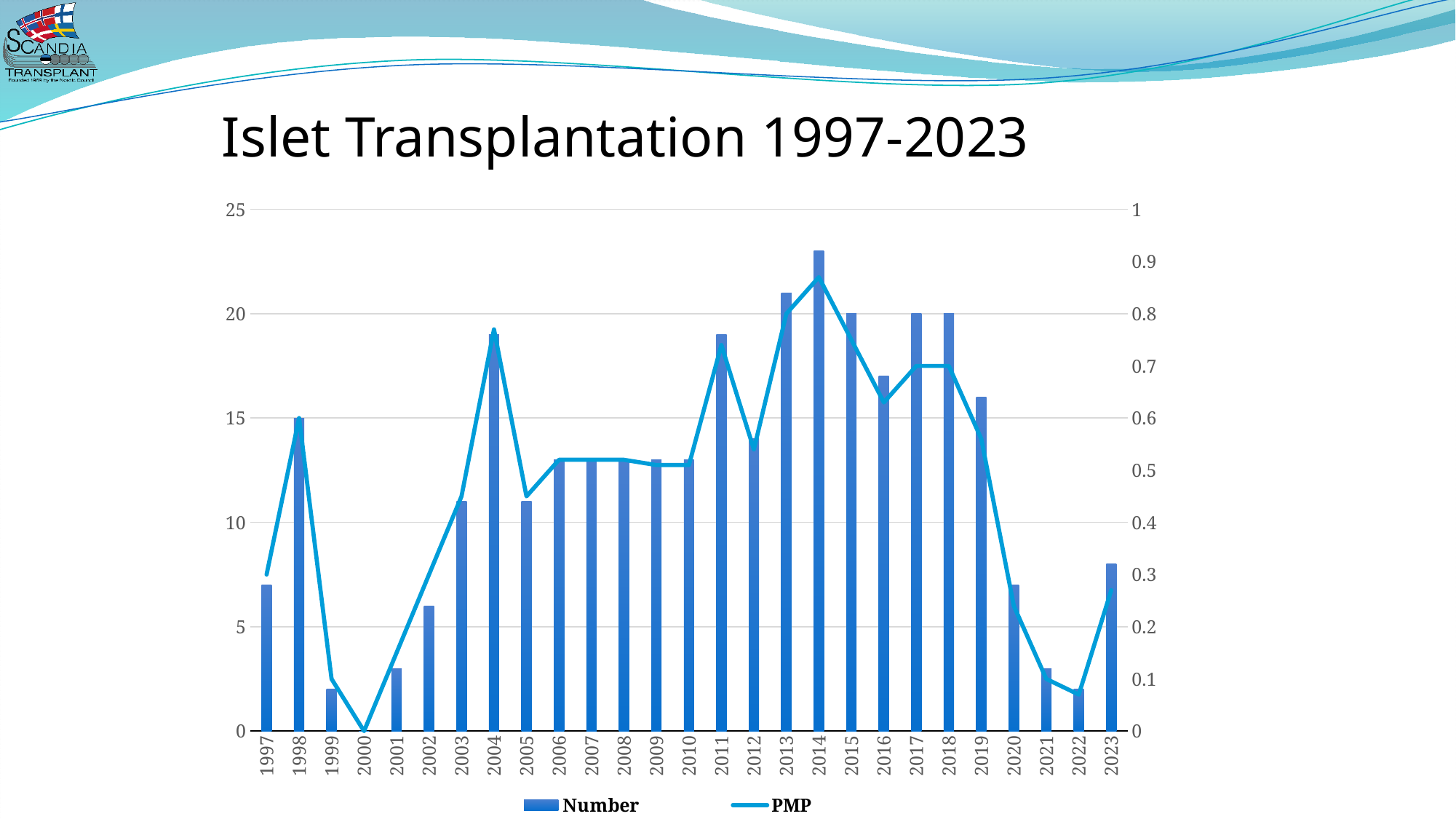
What kind of chart is shown on the slide? bar chart with a line What is the Number value for 1998? 15 How many series does the legend list? 2 How many years are shown on the x axis? 27 Is the Number value for 2020 greater or less than 10? less Which year has the larger Number bar, 2004 or 2005? 2004 Is the Number value for 2004 greater or less than 15? greater What are the two entries in the legend? Number and PMP Which year has the highest Number bar? 2014 Do the Number bars rise or fall from 2018 to 2022? fall What is the Number value for 2015? 20 Which year has the lowest Number bar? 2000